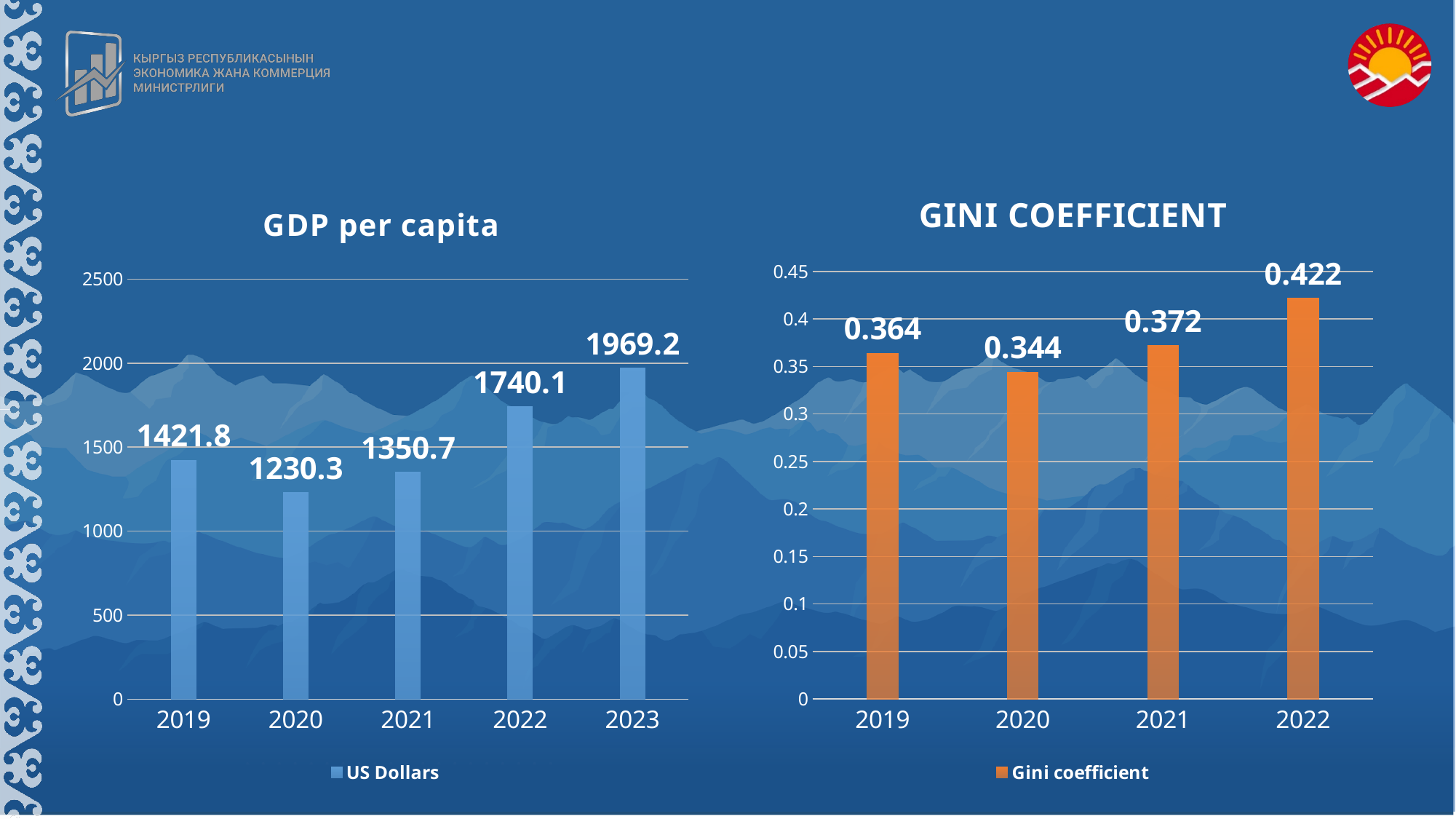
In the GINI COEFFICIENT chart, what is the difference between the 2022 and 2019 values? 0.058 In the GDP per capita chart, what is the value for 2021? 1350.7 In the GDP per capita chart, is the value for 2022 greater or less than 1500? greater What kind of chart is the GINI COEFFICIENT chart? Bar chart In the GINI COEFFICIENT chart, which year has the highest value? 2022 In the GDP per capita chart, what is the difference between the 2023 and 2022 values? 229.1 In the GINI COEFFICIENT chart, which is larger, the value for 2019 or the value for 2021? 2021 In the GDP per capita chart, which year has the lowest value? 2020 In the GDP per capita chart, how many years are shown on the x axis? 5 What is the legend entry of the GDP per capita chart? US Dollars In the GINI COEFFICIENT chart, what is the value for 2020? 0.344 In the GDP per capita chart, which year has the highest value? 2023